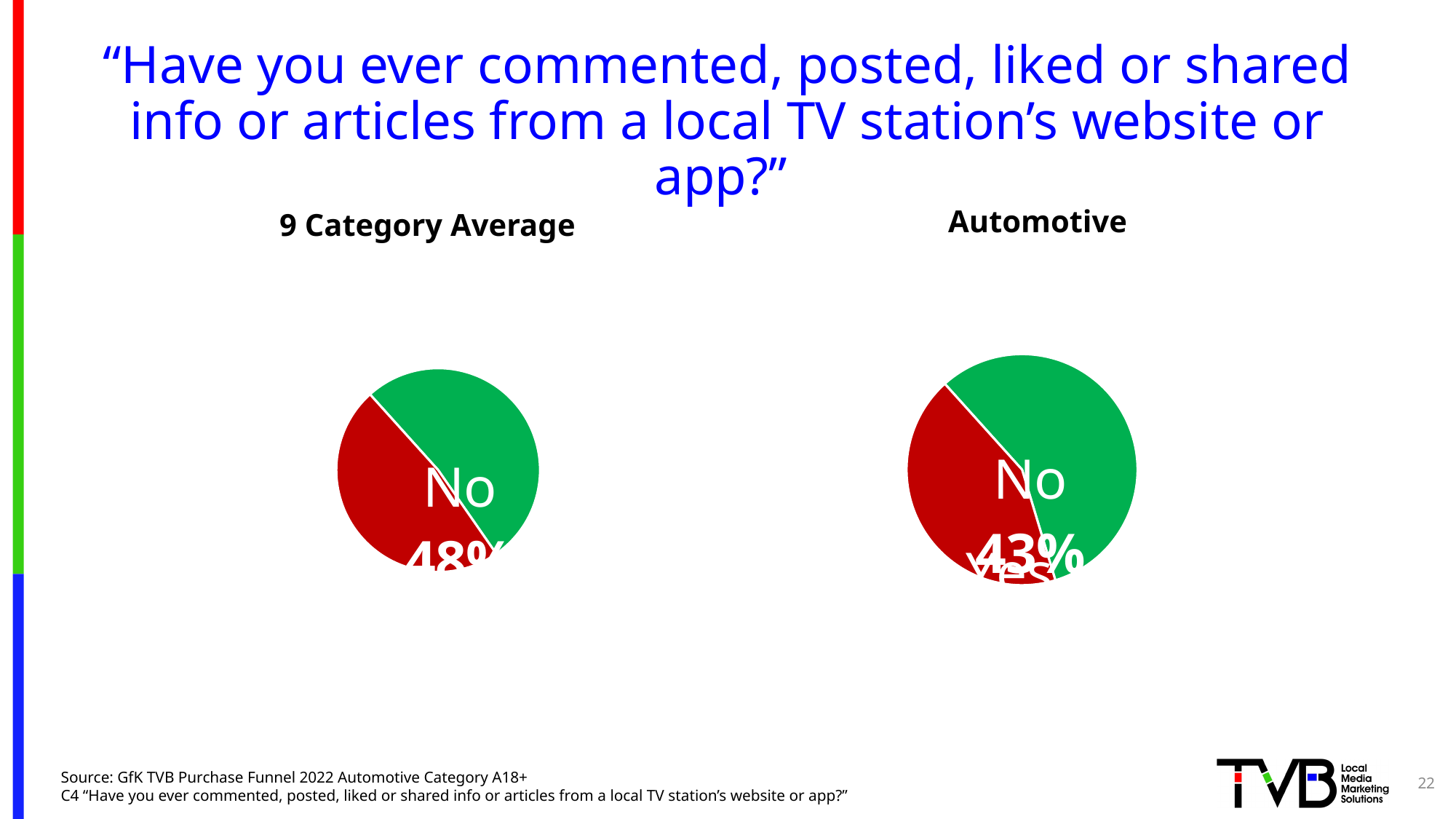
What colour is the No slice in both pie charts? Red In the 9 Category Average chart, which slice is larger, the red No slice or the green slice? The green slice In the 9 Category Average chart, what percentage answered No? 48% In the Automotive chart, what percentage answered No? 43% What are the titles of the two pie charts on the slide? 9 Category Average and Automotive How many slices does the Automotive pie chart have? 2 Which chart shows a larger share of No responses, 9 Category Average or Automotive? 9 Category Average What is the difference in percentage points between the No share in the 9 Category Average chart and the No share in the Automotive chart? 5 percentage points What type of charts are shown on the slide? Pie charts In the Automotive chart, is the No share greater or less than 50%? less In the Automotive chart, which slice is larger, the red No slice or the green slice? The green slice